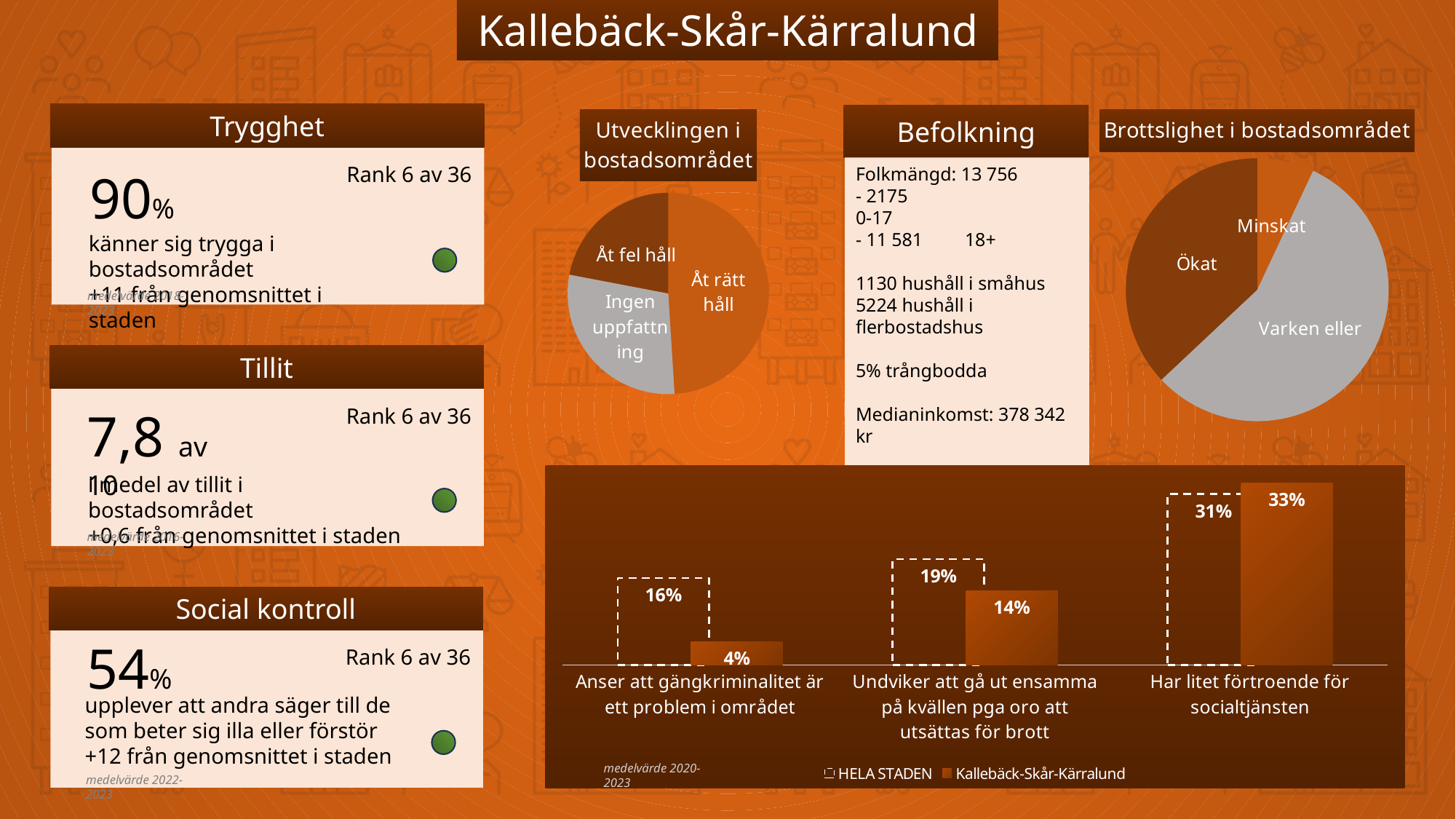
How many categories are shown in the bar chart at the bottom of the slide? 3 In the bar chart at the bottom of the slide, what is the value for HELA STADEN for 'Har litet förtroende för socialtjänsten'? 31% In the bar chart at the bottom of the slide, which category has the highest value for Kallebäck-Skår-Kärralund? Har litet förtroende för socialtjänsten In the bar chart at the bottom of the slide, which series has the larger value for 'Har litet förtroende för socialtjänsten'? Kallebäck-Skår-Kärralund What kind of chart is the chart at the bottom of the slide with the legend 'HELA STADEN' and 'Kallebäck-Skår-Kärralund'? Bar chart In the bar chart at the bottom of the slide, which category has the lowest value for HELA STADEN? Anser att gängkriminalitet är ett problem i området In the pie chart 'Brottslighet i bostadsområdet', which slice is the smallest? Minskat How many slices does the pie chart 'Brottslighet i bostadsområdet' have? 3 In the bar chart at the bottom of the slide, what is the difference between HELA STADEN and Kallebäck-Skår-Kärralund for 'Undviker att gå ut ensamma på kvällen pga oro att utsättas för brott'? 5 percentage points In the bar chart at the bottom of the slide, what is the value for Kallebäck-Skår-Kärralund for 'Anser att gängkriminalitet är ett problem i området'? 4% In the pie chart 'Utvecklingen i bostadsområdet', which slice is the largest? Åt rätt håll How many series does the legend of the bar chart at the bottom of the slide list? 2